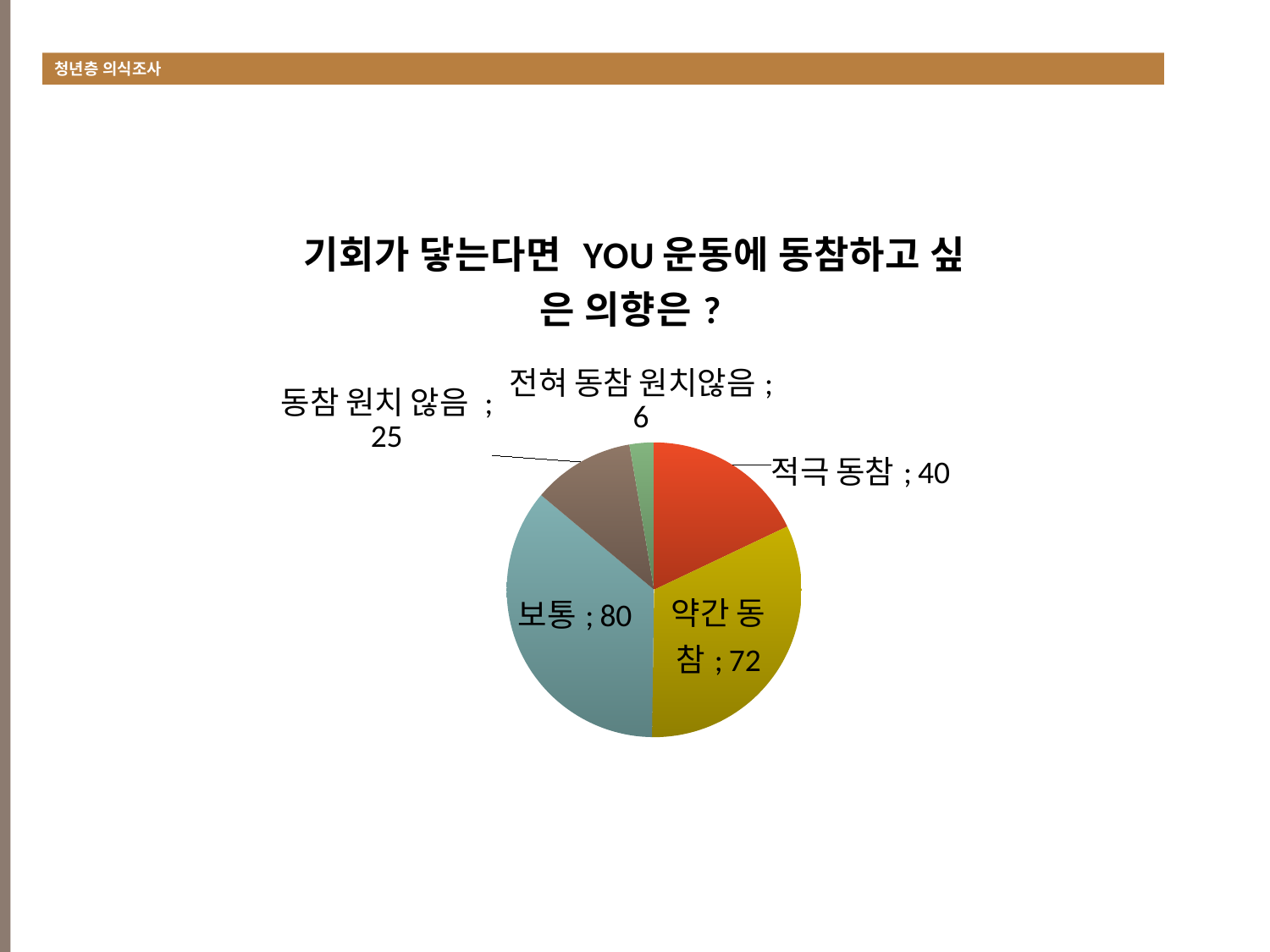
Which category has the smallest slice in the pie chart? 전혀 동참 원치않음 What is the value for 적극 동참 in the pie chart? 40 Which is larger, the value for 적극 동참 or the value for 동참 원치 않음? 적극 동참 What is the total of all the values shown in the pie chart? 223 What type of chart is shown on the slide? pie chart What is the title of the pie chart? 기회가 닿는다면 YOU 운동에 동참하고 싶은 의향은 ? Which category has the largest slice in the pie chart? 보통 What is the value for 동참 원치 않음 in the pie chart? 25 What is the value for 보통 in the pie chart? 80 What is the difference between the values for 보통 and 약간 동참? 8 How many categories (slices) does the pie chart have? 5 What is the value for 전혀 동참 원치않음 in the pie chart? 6